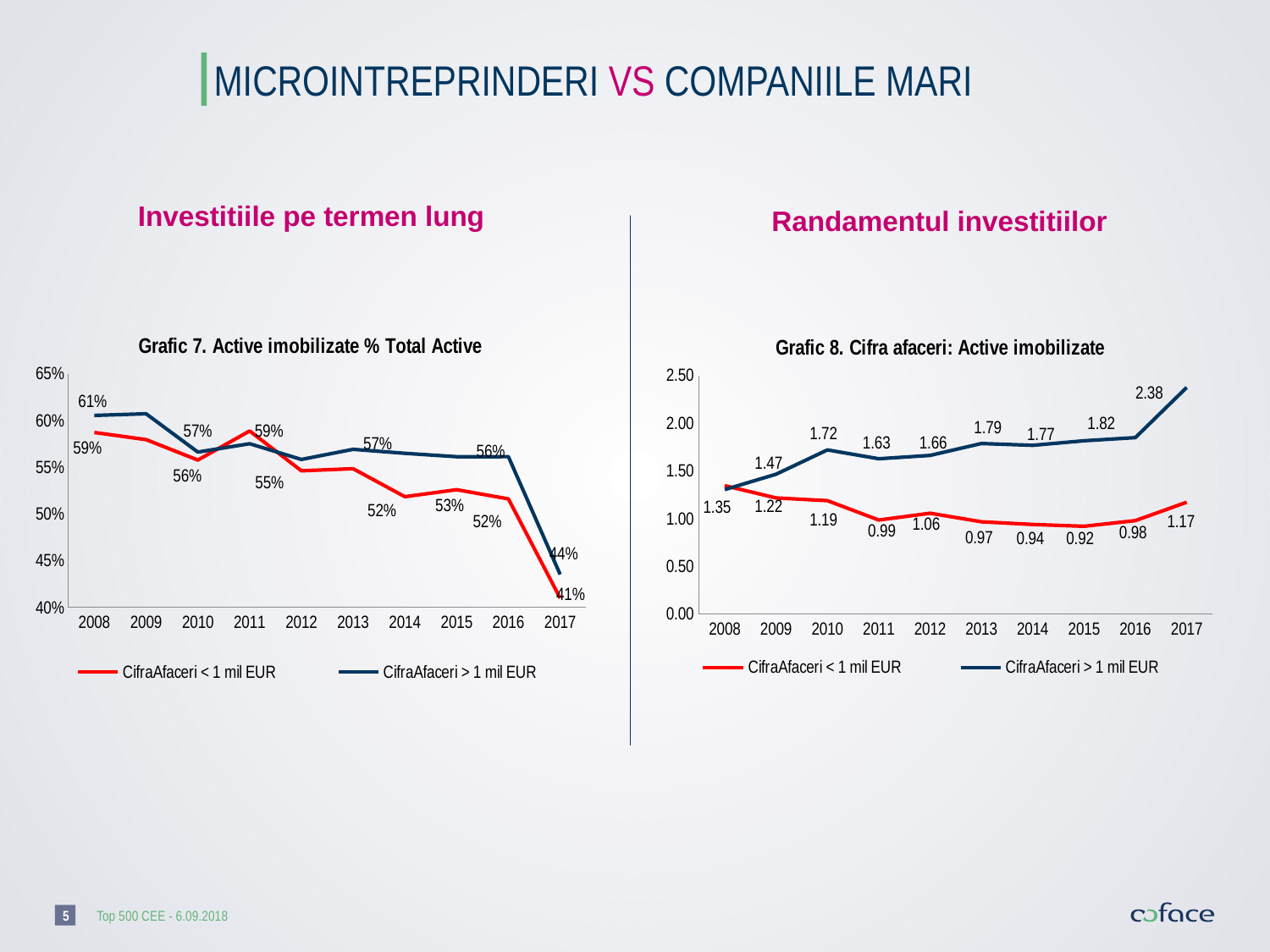
In Grafic 8. Cifra afaceri: Active imobilizate, what is the difference between the two series in 2017? 1.21 In Grafic 8. Cifra afaceri: Active imobilizate, what is the value for CifraAfaceri < 1 mil EUR in 2015? 0.92 In Grafic 8. Cifra afaceri: Active imobilizate, does the CifraAfaceri > 1 mil EUR series rise or fall from 2008 to 2017? rise In Grafic 8. Cifra afaceri: Active imobilizate, in which year is the CifraAfaceri > 1 mil EUR series highest? 2017 In Grafic 8. Cifra afaceri: Active imobilizate, what is the value for CifraAfaceri > 1 mil EUR in 2017? 2.38 In Grafic 8. Cifra afaceri: Active imobilizate, in which year is the CifraAfaceri < 1 mil EUR series lowest? 2015 How many years are shown on the x axis of Grafic 8. Cifra afaceri: Active imobilizate? 10 What kind of chart is Grafic 7. Active imobilizate % Total Active? line chart In Grafic 7. Active imobilizate % Total Active, which series has the larger value in 2017? CifraAfaceri > 1 mil EUR In Grafic 7. Active imobilizate % Total Active, what is the value for CifraAfaceri < 1 mil EUR in 2017? 41% In Grafic 7. Active imobilizate % Total Active, what is the value for CifraAfaceri > 1 mil EUR in 2008? 61% How many series does the legend of Grafic 7. Active imobilizate % Total Active list? 2